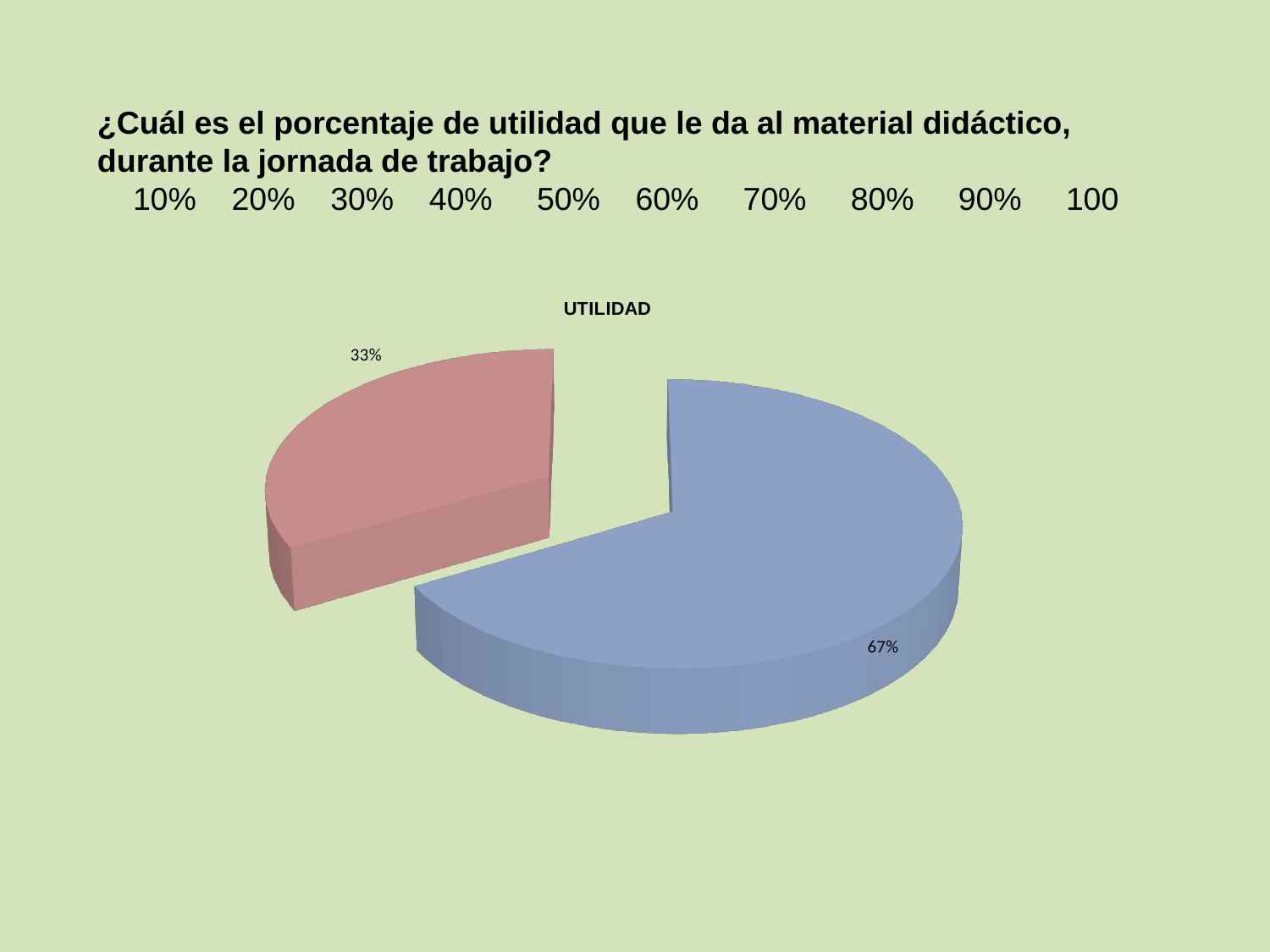
What percentage is shown on the pink slice of the pie chart? 33% Which slice of the pie chart is the largest? the blue slice (67%) What kind of chart is shown on the slide? pie chart What is the title of the chart? UTILIDAD How many slices does the pie chart have? 2 Is the value of the pink slice greater or less than 50%? less Which slice of the pie chart is the smallest? the pink slice (33%) Which slice is larger, the blue one or the pink one? the blue one What is the difference in percentage points between the blue slice and the pink slice? 34 What share of the pie does the blue slice represent? 67% What percentage is shown on the blue slice of the pie chart? 67%